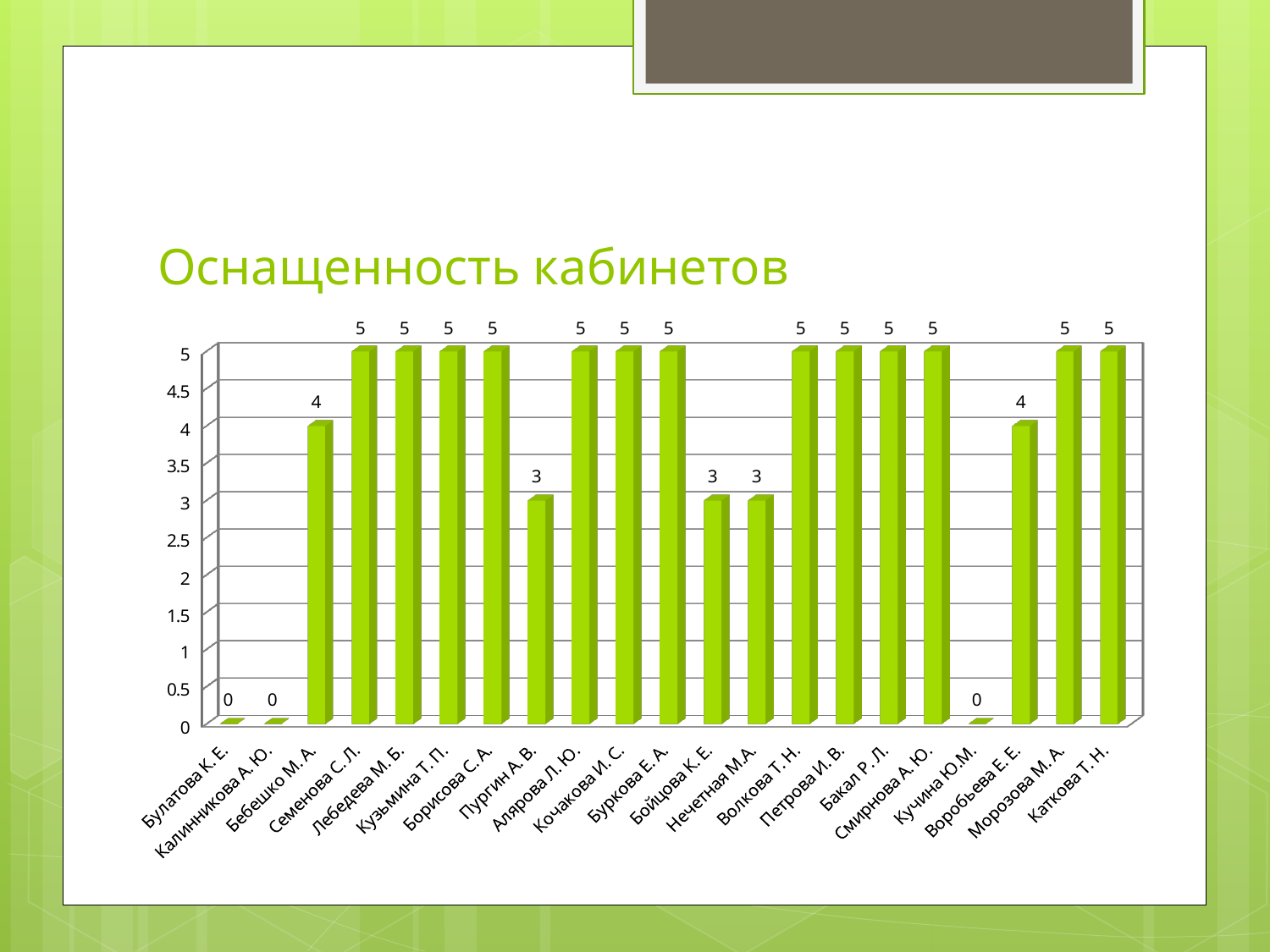
How many categories are shown on the x axis? 21 What kind of chart is shown on the slide? Bar chart What is the value for Кучина Ю.М.? 0 What is the value for Пургин А. В.? 3 Which has the larger value, Бебешко М. А. or Пургин А. В.? Бебешко М. А. What is the value for Каткова Т. Н.? 5 What is the title of the chart? Оснащенность кабинетов What is the highest value shown on the vertical axis? 5 Which has the larger value, Воробьева Е. Е. or Морозова М. А.? Морозова М. А. What is the difference between the values for Семенова С. Л. and Бойцова К. Е.? 2 What is the value for Бебешко М. А.? 4 What is the value for Нечетная М.А.? 3